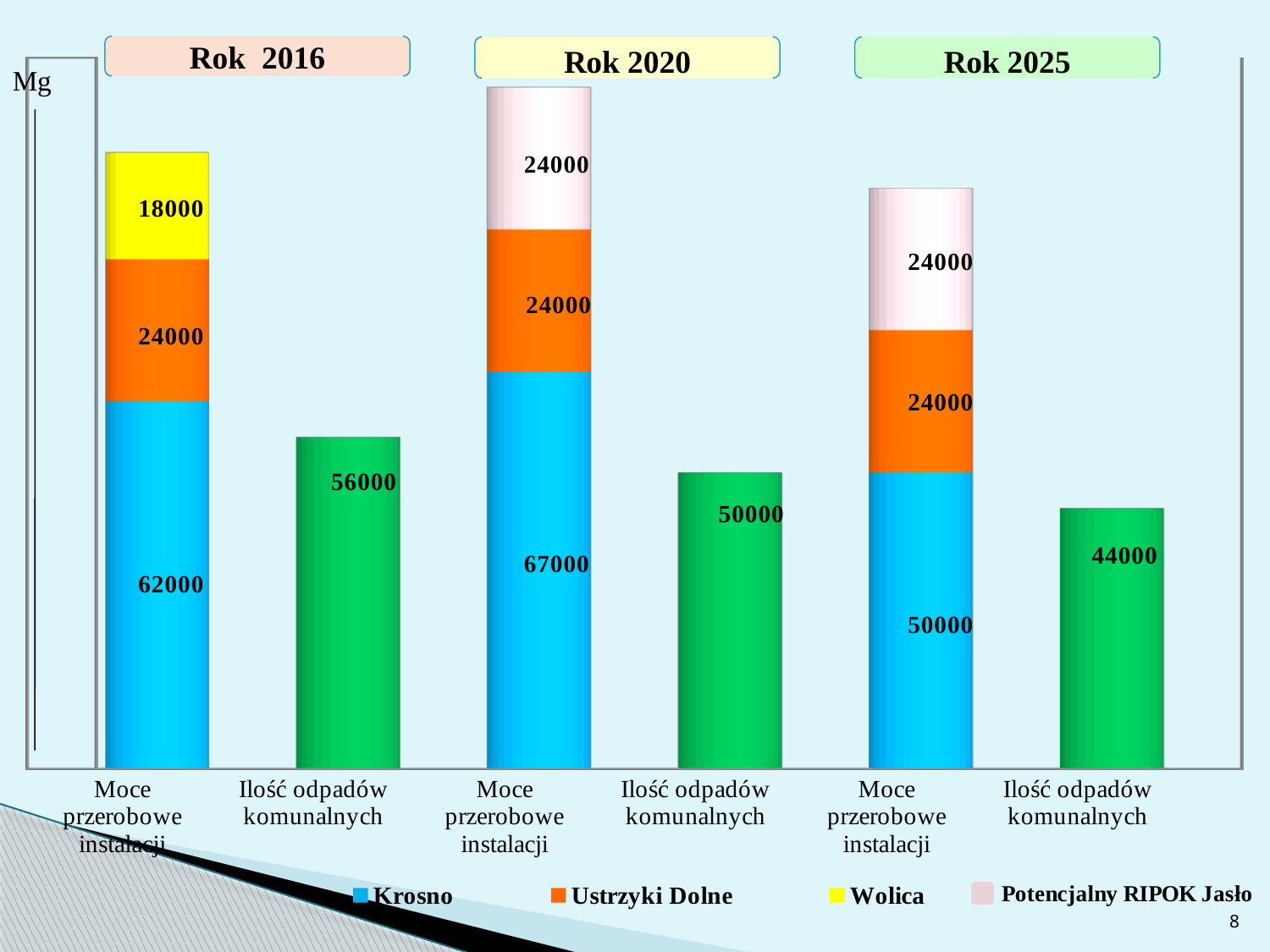
What is the total of the stacked Moce przerobowe instalacji bar for Rok 2025? 98000 Which year has the highest value of Ilość odpadów komunalnych? Rok 2016 Do the Ilość odpadów komunalnych values rise or fall from Rok 2016 to Rok 2025? fall What kind of chart is shown on the slide? stacked bar chart What is the difference between the Krosno values for Rok 2020 and Rok 2025? 17000 What is the value for Potencjalny RIPOK Jasło in the Moce przerobowe instalacji bar for Rok 2025? 24000 What is the value for Krosno in the Moce przerobowe instalacji bar for Rok 2016? 62000 What is the total of the stacked Moce przerobowe instalacji bar for Rok 2016? 104000 What is the value for Wolica in the Moce przerobowe instalacji bar for Rok 2016? 18000 What is the value of Ilość odpadów komunalnych for Rok 2020? 50000 What is the total of the stacked Moce przerobowe instalacji bar for Rok 2020? 115000 How many series does the legend list? 4